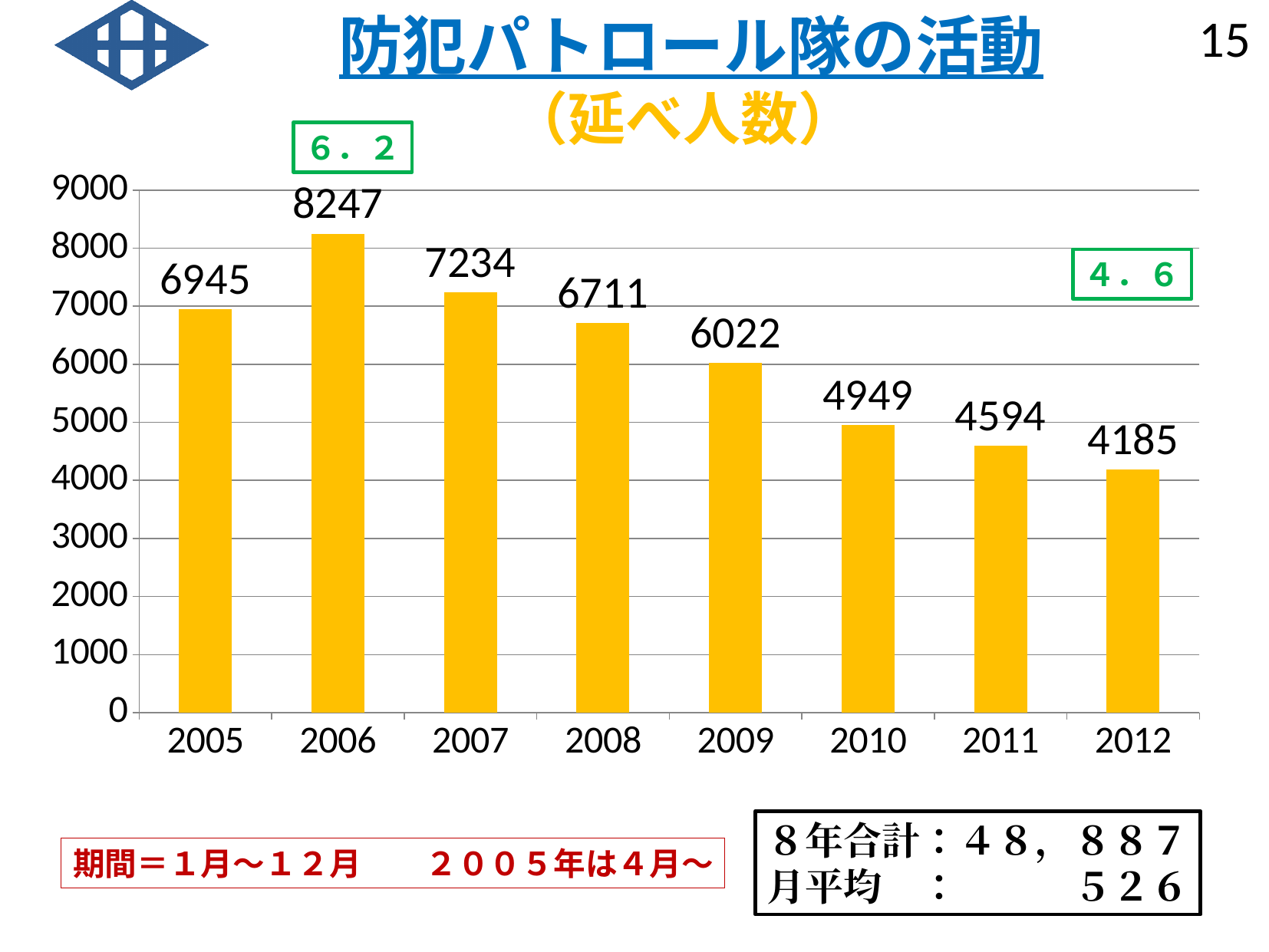
What kind of chart is shown on the slide? bar chart Is the value for 2010 greater or less than 5000? less What is the value for 2006? 8247 How many years are shown on the x axis? 8 What is the difference between the values for 2006 and 2007? 1013 What is the value for 2009? 6022 What is the difference between the values for 2010 and 2011? 355 Which is larger, the value for 2005 or the value for 2008? 2005 Which year has the lowest value? 2012 What is the value for 2012? 4185 Do the values rise or fall from 2006 to 2012? fall Which year has the highest value? 2006